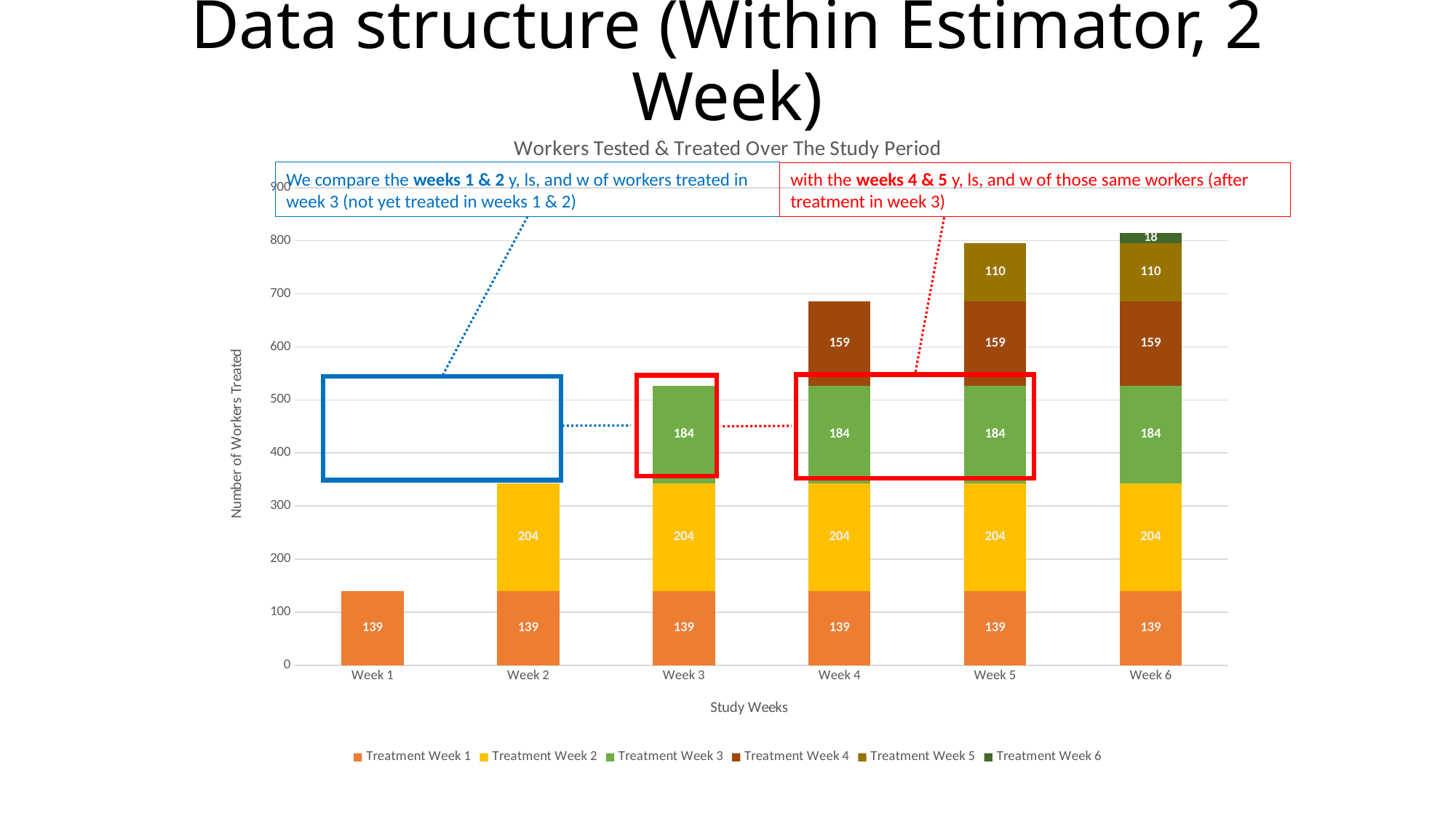
What is the difference between the Treatment Week 2 segment and the Treatment Week 3 segment in the Week 3 bar? 20 What is the value of the Treatment Week 5 segment in the Week 5 bar? 110 Which week has the lowest total bar? Week 1 What is the value of the Treatment Week 1 segment in the Week 3 bar? 139 What kind of chart is shown on the slide? Stacked bar chart What is the total of the Week 2 bar? 343 What is the value of the Treatment Week 6 segment in the Week 6 bar? 18 How many study weeks are shown on the x axis? 6 What is the total of the Week 4 bar? 686 What is the title of the chart? Workers Tested & Treated Over The Study Period Do the total bar heights rise or fall from Week 1 to Week 6? Rise How many series does the legend list? 6